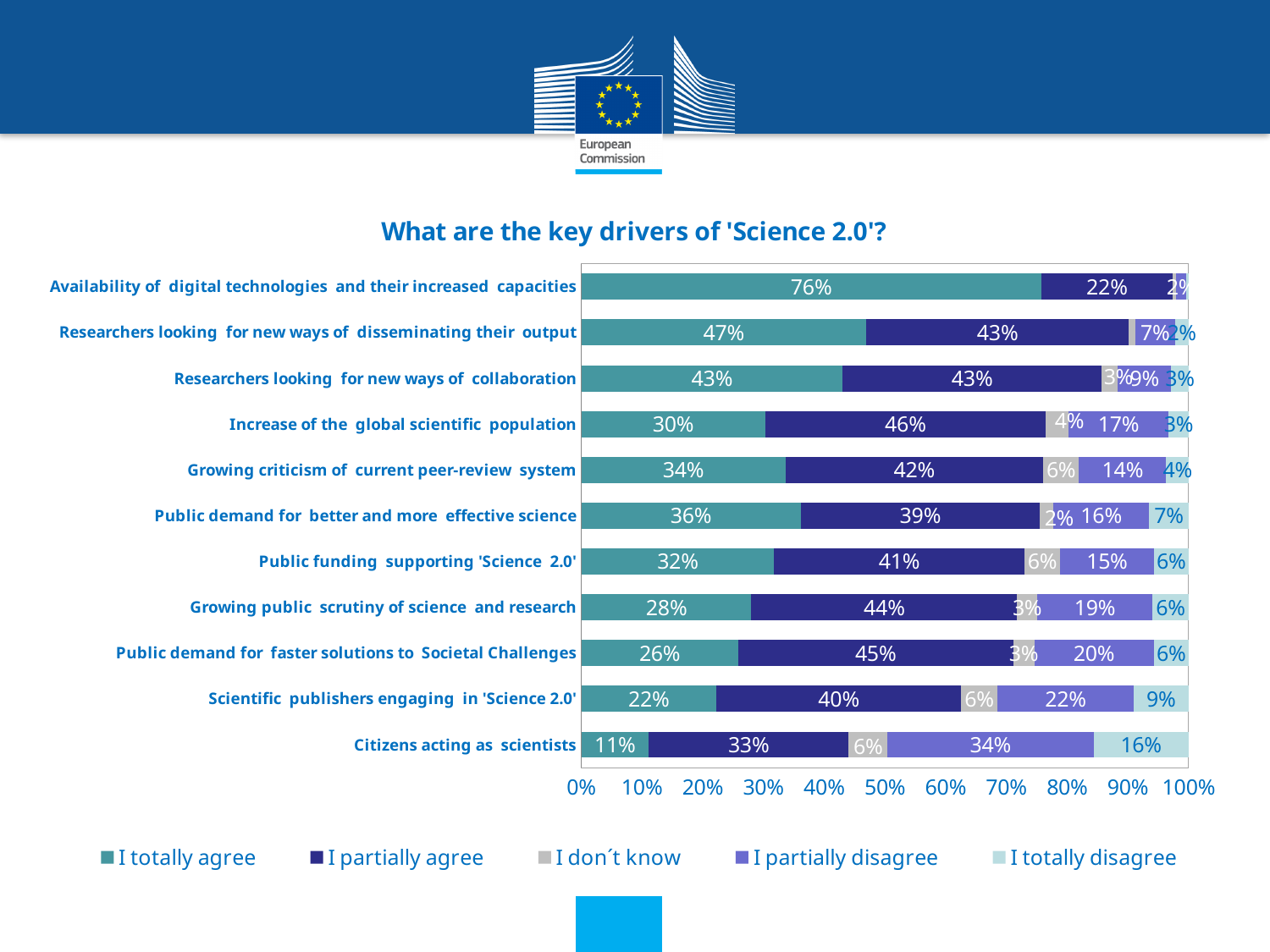
Which has a larger 'I partially agree' value: 'Increase of the global scientific population' or 'Growing criticism of current peer-review system'? Increase of the global scientific population What is the 'I totally disagree' value for 'Scientific publishers engaging in Science 2.0'? 9% How many drivers (categories) are listed in the chart? 11 What is the 'I partially agree' value for 'Citizens acting as scientists'? 33% What is the 'I partially disagree' value for 'Public demand for faster solutions to Societal Challenges'? 20% How many response options does the legend list? 5 Which driver has the lowest 'I totally agree' share? Citizens acting as scientists Which driver has the highest 'I totally agree' share? Availability of digital technologies and their increased capacities Which driver has the highest 'I totally disagree' share? Citizens acting as scientists What percentage of respondents totally agree that 'Availability of digital technologies and their increased capacities' is a key driver of Science 2.0? 76% What is the difference between the 'I totally agree' values for 'Researchers looking for new ways of disseminating their output' and 'Researchers looking for new ways of collaboration'? 4% What type of chart is shown on the slide? Stacked bar chart